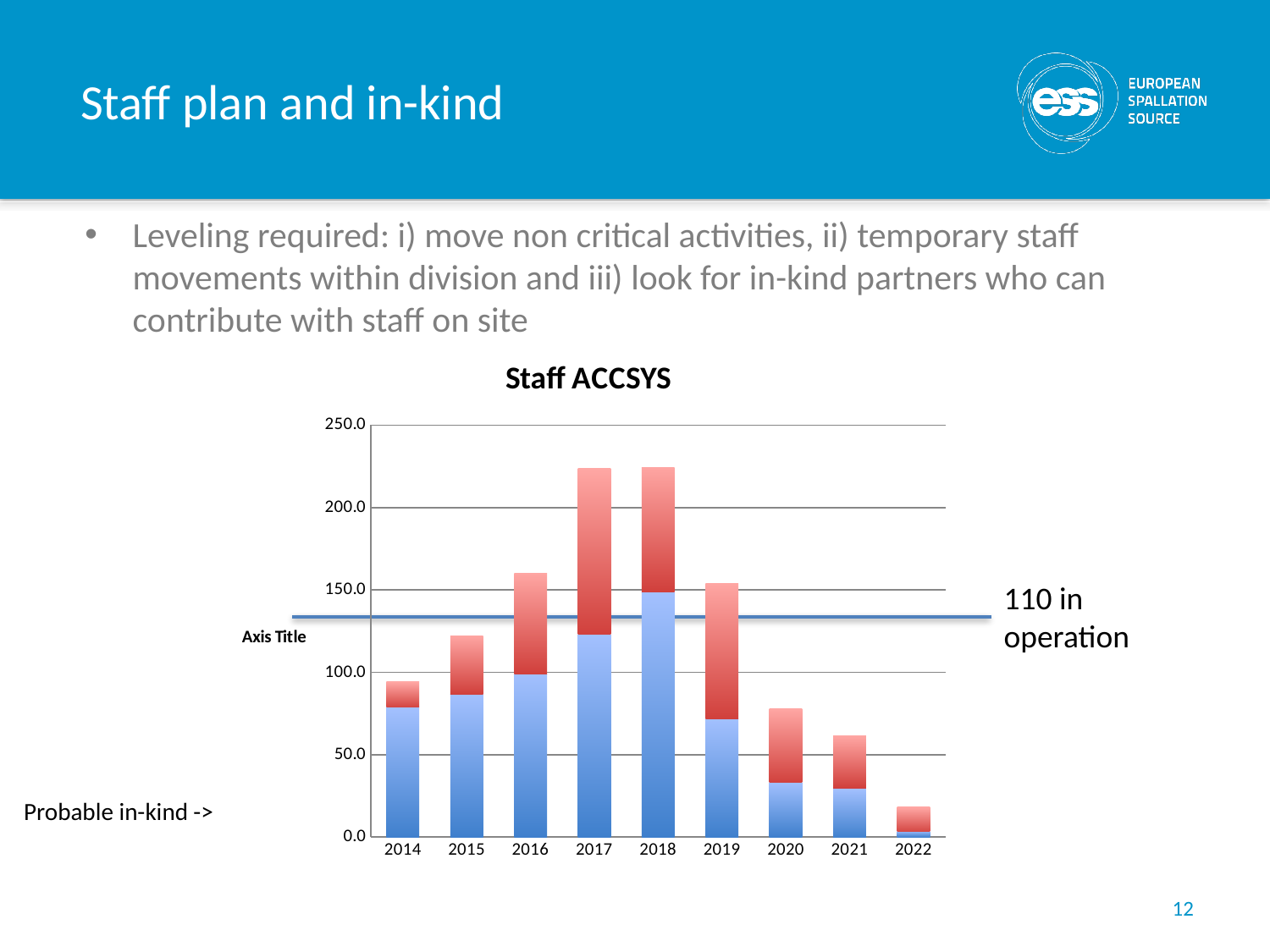
What label is written next to the horizontal line drawn across the Staff ACCSYS chart? 110 in operation Is the total bar for 2014 in the Staff ACCSYS chart greater or less than 100.0? less In the Staff ACCSYS chart, which year has the taller total bar, 2015 or 2020? 2015 What is the title of the chart on the slide? Staff ACCSYS Which year has the lowest total bar in the Staff ACCSYS chart? 2022 In the Staff ACCSYS chart, which year has the taller total bar, 2014 or 2021? 2014 What kind of chart is shown on the slide? Stacked bar chart In the Staff ACCSYS chart, do the total bars rise or fall from 2018 to 2022? fall Is the total bar for 2017 in the Staff ACCSYS chart greater or less than 200.0? greater How many years are shown along the x axis of the Staff ACCSYS chart? 9 Is the total bar for 2020 in the Staff ACCSYS chart greater or less than 50.0? greater